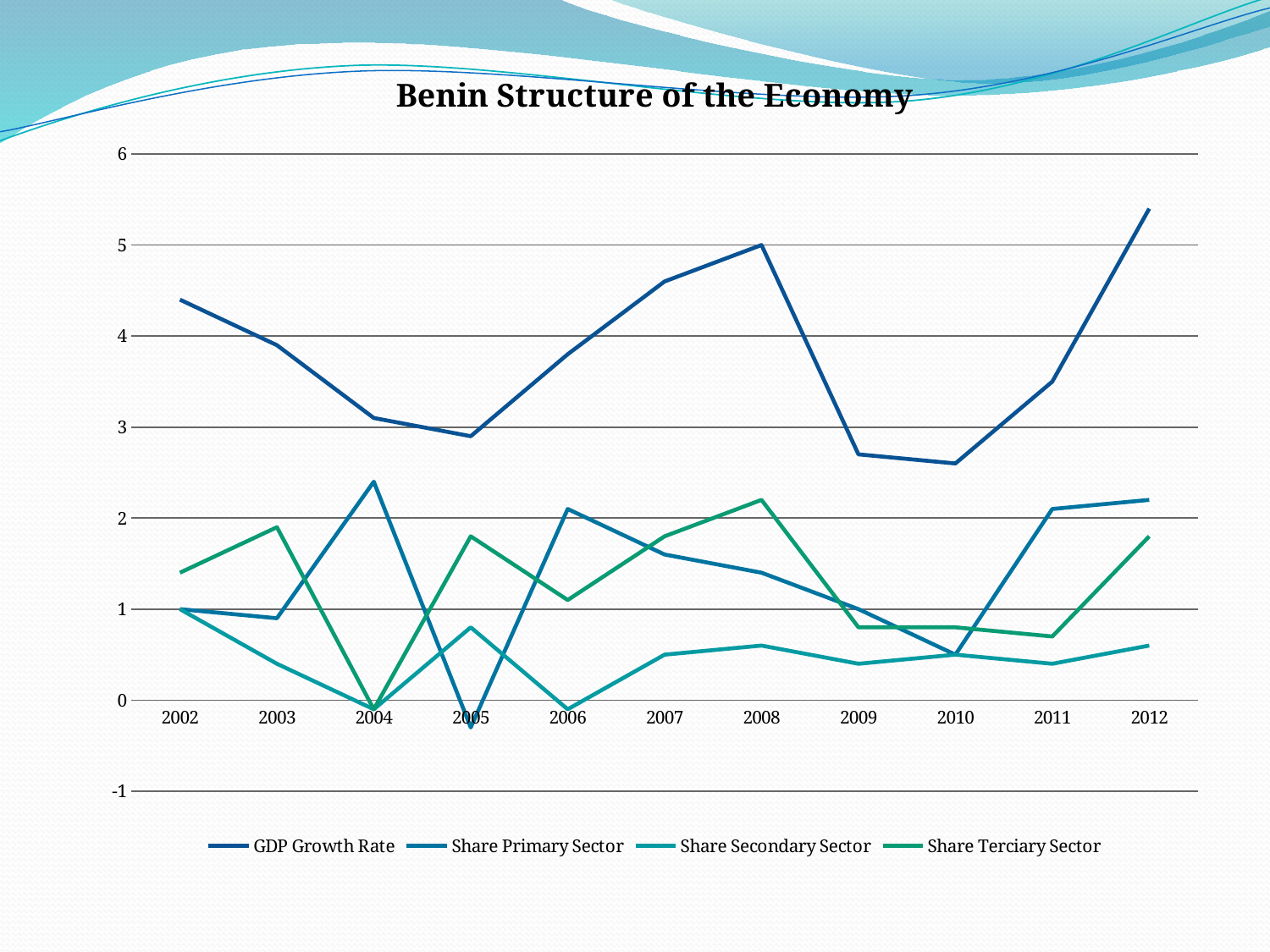
How many series does the legend list? 4 What is the title of the chart? Benin Structure of the Economy Is the GDP Growth Rate for 2010 greater or less than 3? less How many years are plotted along the x axis? 11 What kind of chart is shown on the slide? line chart Which series has the highest values across the whole chart? GDP Growth Rate Is the GDP Growth Rate for 2012 greater or less than 5? greater Is the Share Primary Sector value for 2004 greater or less than 2? greater Does the GDP Growth Rate rise or fall from 2010 to 2012? rise In 2008, which is larger: Share Terciary Sector or Share Primary Sector? Share Terciary Sector In which year is the GDP Growth Rate highest? 2012